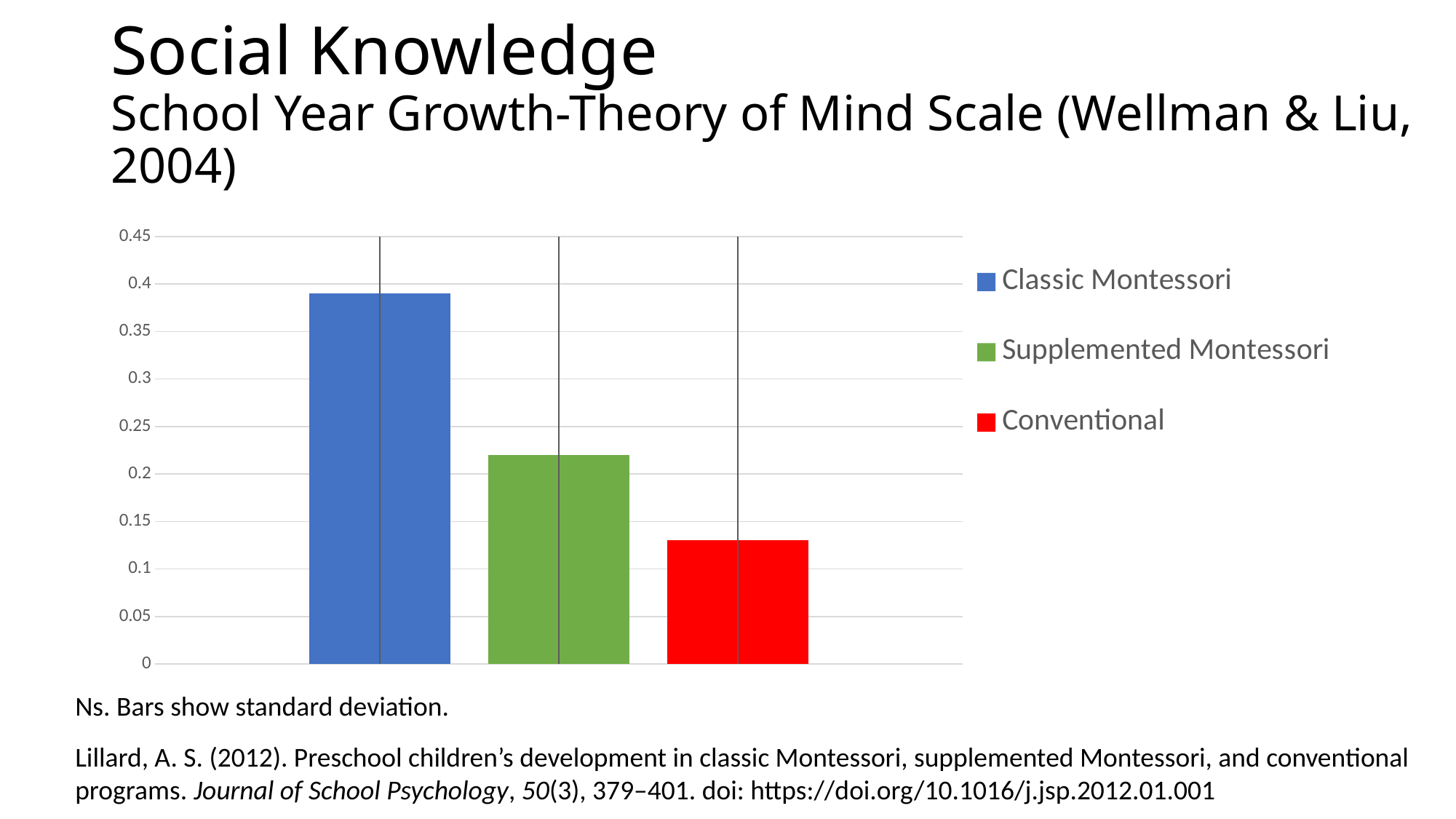
Which is larger, the value for Classic Montessori or the value for Supplemented Montessori? Classic Montessori Is the value for Conventional greater or less than 0.1? greater Is the value for Classic Montessori greater or less than 0.35? greater How many bars are plotted in the chart? 3 What colour is the bar for Conventional? red What kind of chart is shown on the slide? bar chart Is the value for Supplemented Montessori greater or less than 0.25? less Which is larger, the value for Supplemented Montessori or the value for Conventional? Supplemented Montessori Which group has the lowest school year growth on the Theory of Mind Scale? Conventional Which group has the highest school year growth on the Theory of Mind Scale? Classic Montessori How many series does the legend list? 3